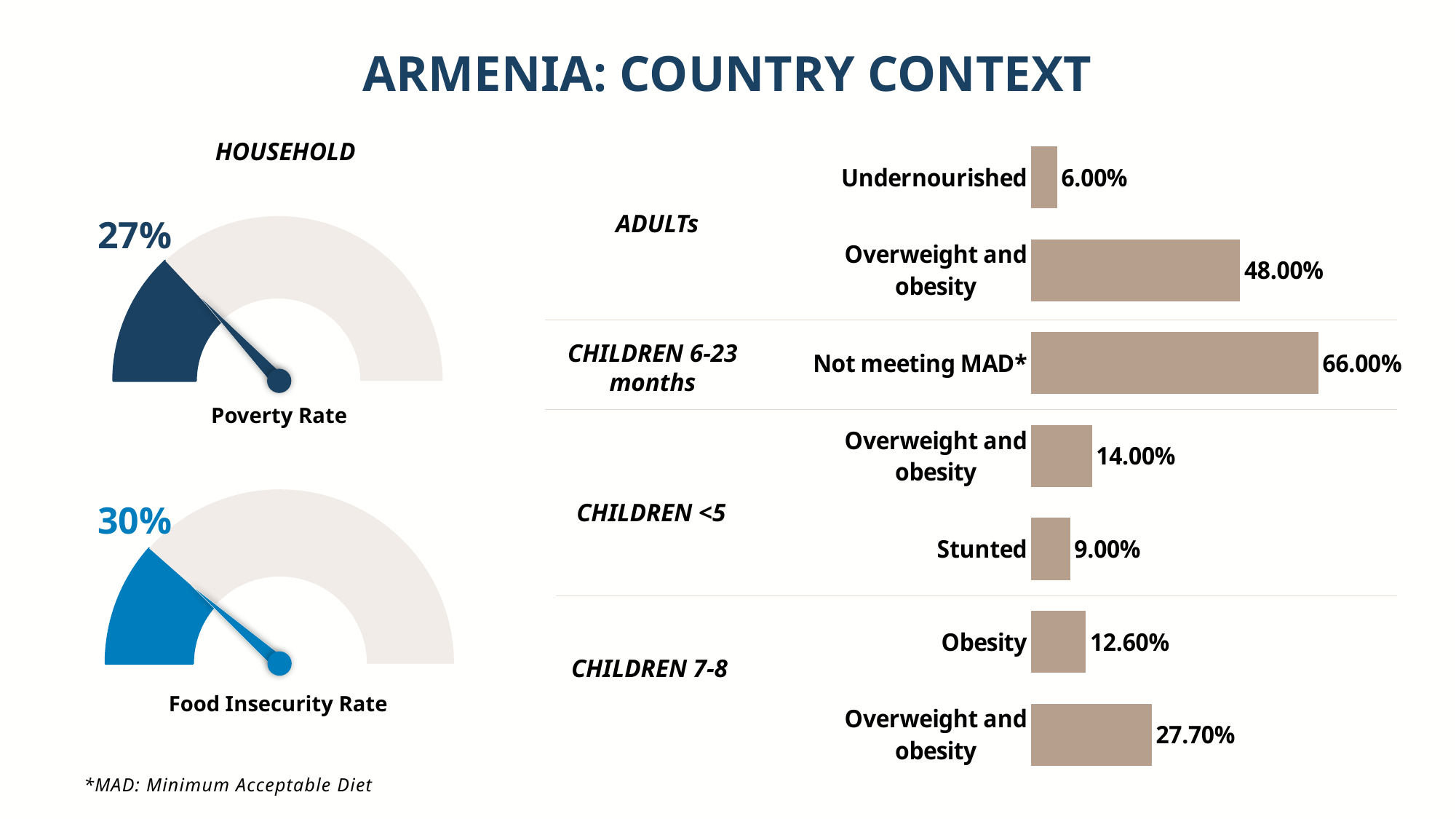
What value does the Food Insecurity Rate gauge show? 30% On the bar chart, what is the value for Not meeting MAD* among children 6-23 months? 66.00% On the bar chart, which category has the highest value? Not meeting MAD* On the bar chart, what is the value for Obesity among children 7-8? 12.60% How many bars are plotted on the bar chart? 7 What type of chart is used on the right side of the slide? Bar chart On the bar chart, what is the value for Undernourished adults? 6.00% What value does the Poverty Rate gauge show? 27% On the bar chart, which category has the lowest value? Undernourished On the bar chart, what is the difference between Overweight and obesity for adults and Overweight and obesity for children under 5? 34.00% On the bar chart, which is larger: Overweight and obesity for children 7-8 or Overweight and obesity for children under 5? Overweight and obesity for children 7-8 On the bar chart, what is the value for Stunted among children under 5? 9.00%